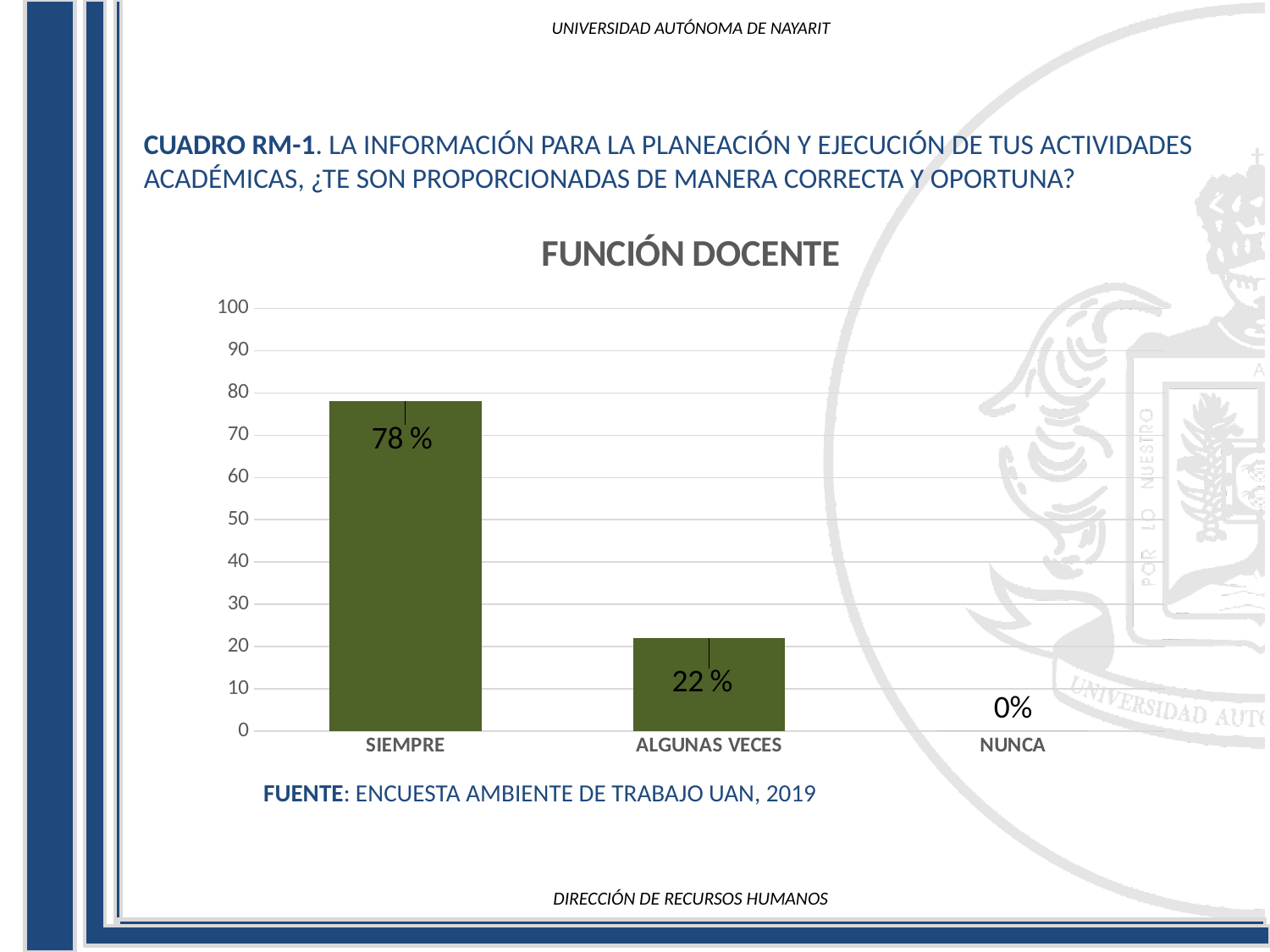
Which is larger, the value for ALGUNAS VECES or the value for NUNCA? ALGUNAS VECES Which category has the highest value? SIEMPRE What is the title of the chart? FUNCIÓN DOCENTE What kind of chart is shown? bar chart What is the value for ALGUNAS VECES? 22 % What is the value for SIEMPRE? 78 % What is the value for NUNCA? 0% Is the value for ALGUNAS VECES greater or less than 30? less Which category has the lowest value? NUNCA How many categories are shown on the x axis? 3 What is the difference between the values for SIEMPRE and ALGUNAS VECES? 56 % Is the value for SIEMPRE greater or less than 50? greater